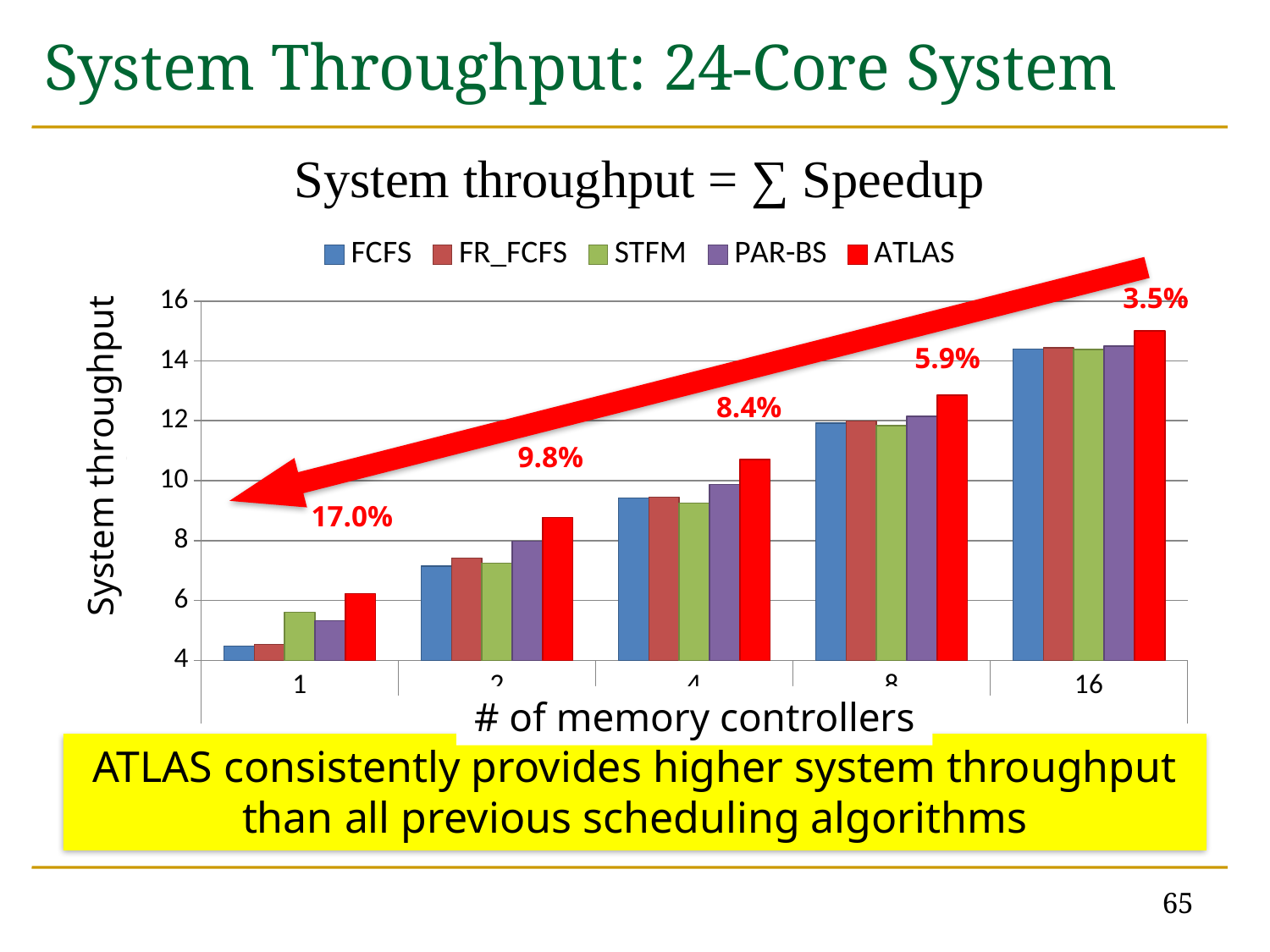
What percentage label is printed above the bars for 1 memory controller? 17.0% Is the ATLAS value for 1 memory controller greater or less than 6? greater Which is larger for 16 memory controllers, the ATLAS value or the FCFS value? ATLAS What kind of chart is shown on the slide? bar chart How many memory-controller categories are shown on the x axis? 5 What is the label on the y axis of the chart? System throughput How many series does the legend list? 5 Which series has the highest system throughput for 1 memory controller? ATLAS Is the ATLAS value for 16 memory controllers greater or less than 14? greater Does the ATLAS system throughput rise or fall as the number of memory controllers increases? rise Is the FCFS value for 1 memory controller greater or less than 6? less Which series has the highest system throughput for 16 memory controllers? ATLAS